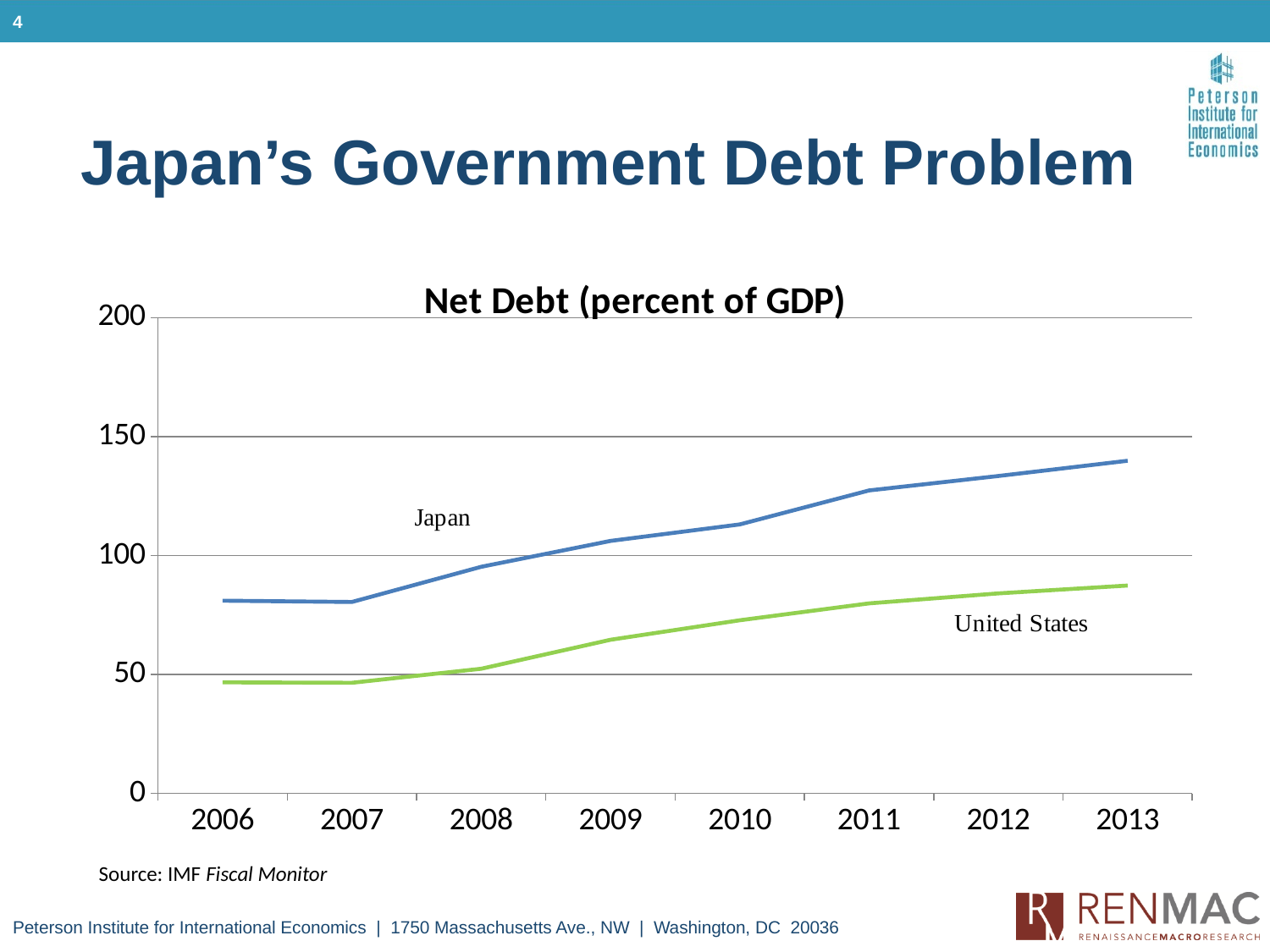
Does Japan's net debt rise or fall from 2007 to 2013? rise Is the value for the United States in 2006 greater or less than 50? less Is the value for Japan in 2011 greater or less than 100? greater In which year is Japan's net debt highest? 2013 How many years are shown on the x axis of the chart? 8 Is the value for Japan in 2013 greater or less than 150? less What kind of chart is shown on the slide? line chart How many series are plotted on the chart? 2 Which series has the higher net debt in 2013, Japan or United States? Japan What is the title of the chart? Net Debt (percent of GDP)